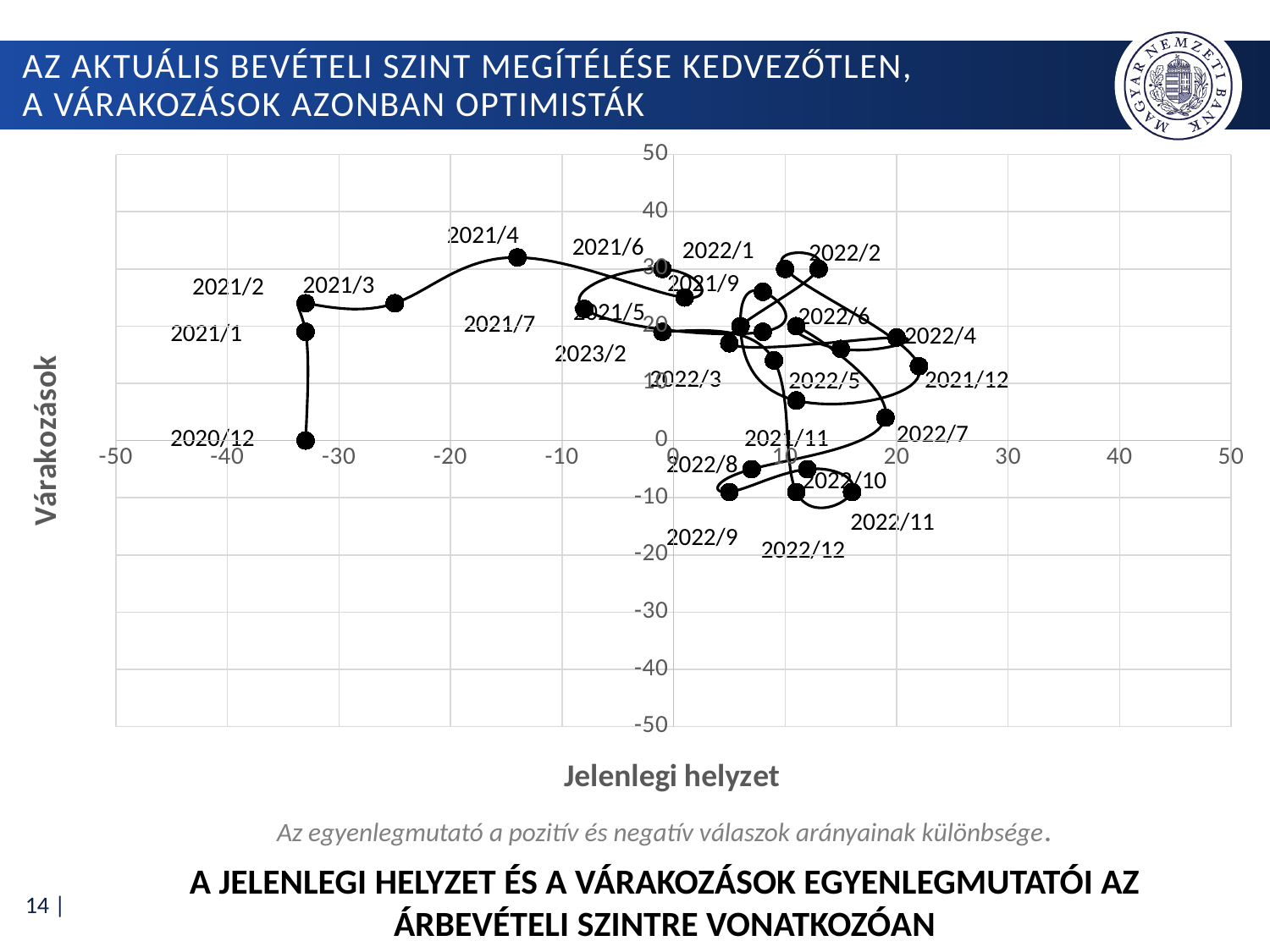
Is the vertical-axis value (Várakozások) for 2022/9 greater or less than 0? less Is the vertical-axis value (Várakozások) for 2022/11 greater or less than 0? less Is the horizontal-axis value (Jelenlegi helyzet) for 2020/12 greater or less than -30? less Which point has the higher horizontal-axis value (Jelenlegi helyzet), 2021/12 or 2021/1? 2021/12 What kind of chart is shown on the slide? scatter chart What is the title of the horizontal axis of the chart? Jelenlegi helyzet What is the title of the vertical axis of the chart? Várakozások Which point has the higher vertical-axis value (Várakozások), 2021/4 or 2020/12? 2021/4